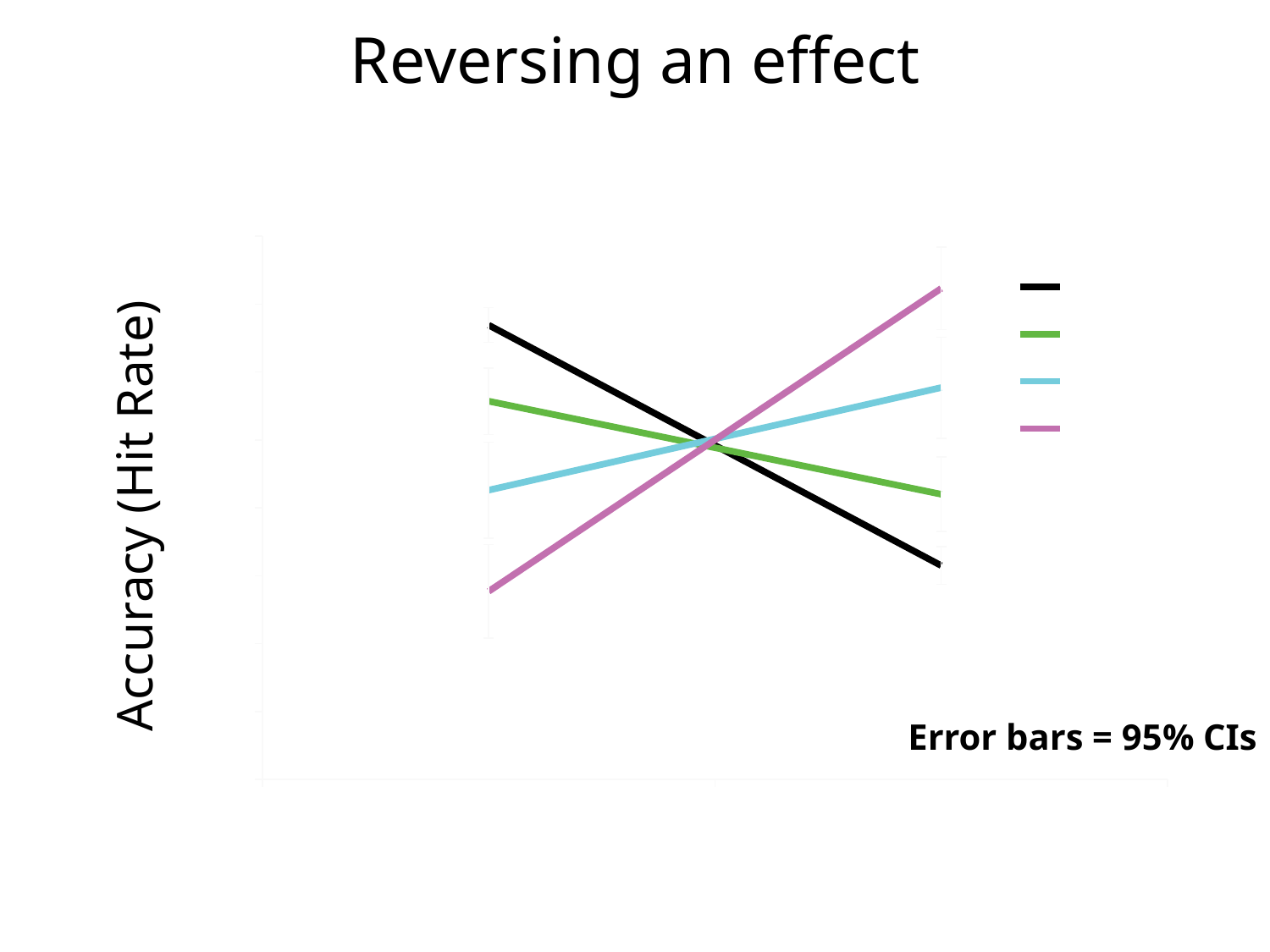
What is the title of the slide? Reversing an effect Does the pink line rise or fall from left to right? rise How many series does the legend list? 4 Which coloured line has the lowest value at the left-hand point? pink What kind of chart is shown on the slide? line chart Which coloured line has the highest value at the right-hand point? pink How many x-axis points does each line connect? 2 Which coloured line has the highest value at the left-hand point? black Does the green line rise or fall from left to right? fall Does the light blue line rise or fall from left to right? rise What is the label on the y axis? Accuracy (Hit Rate)